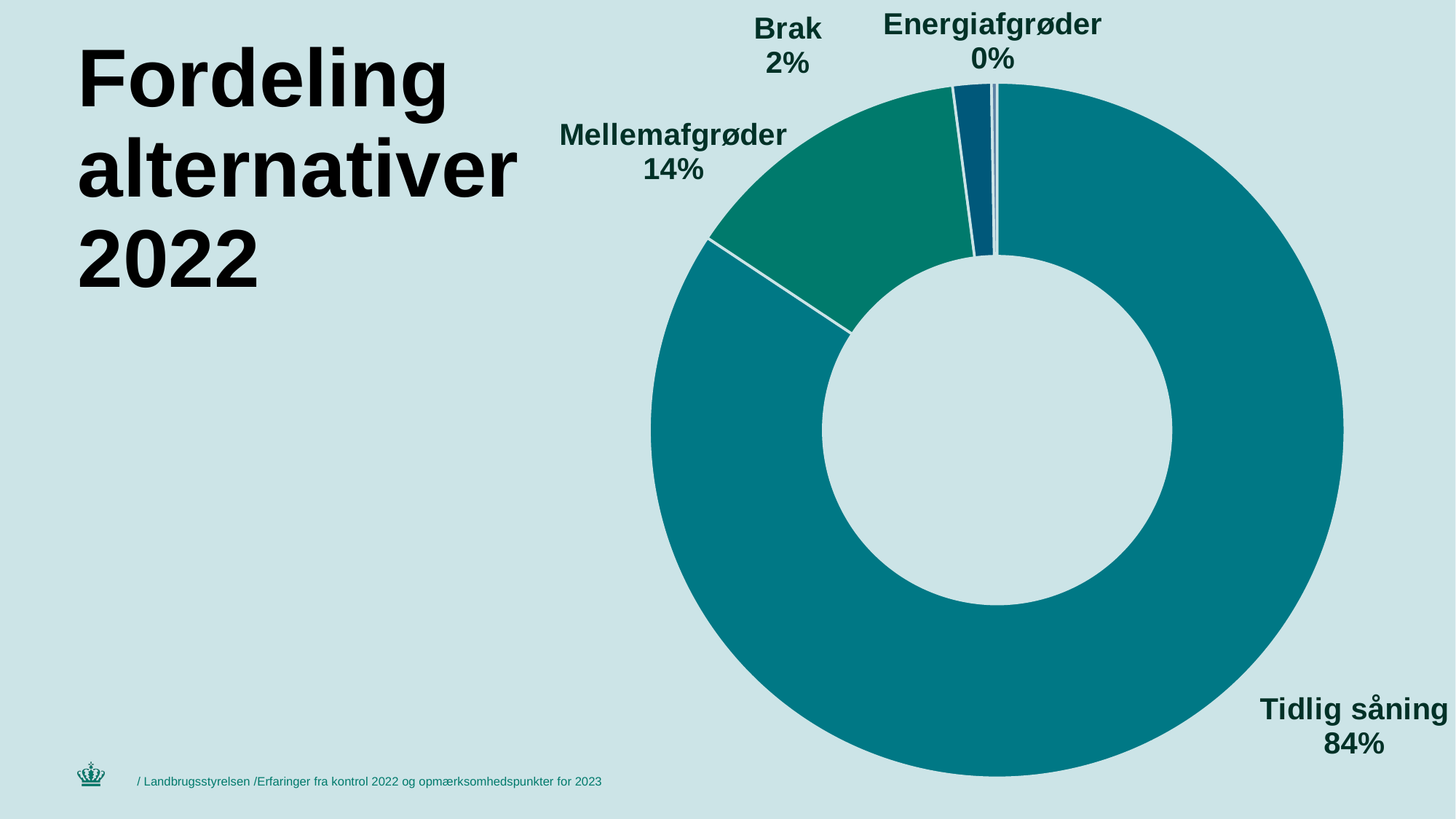
Which has a larger share, Mellemafgrøder or Brak? Mellemafgrøder How many categories are shown in the chart? 4 What is the difference in percentage points between Tidlig såning and Mellemafgrøder? 70 What share of the chart does Tidlig såning account for? 84% Which category has the largest share of the chart? Tidlig såning What kind of chart is shown on the slide? Doughnut (pie) chart What is the title of the slide? Fordeling alternativer 2022 What percentage is shown for Energiafgrøder? 0% Which category has the smallest share of the chart? Energiafgrøder What is the difference in percentage points between Mellemafgrøder and Brak? 12 What percentage is shown for Brak? 2% What percentage is shown for Mellemafgrøder? 14%